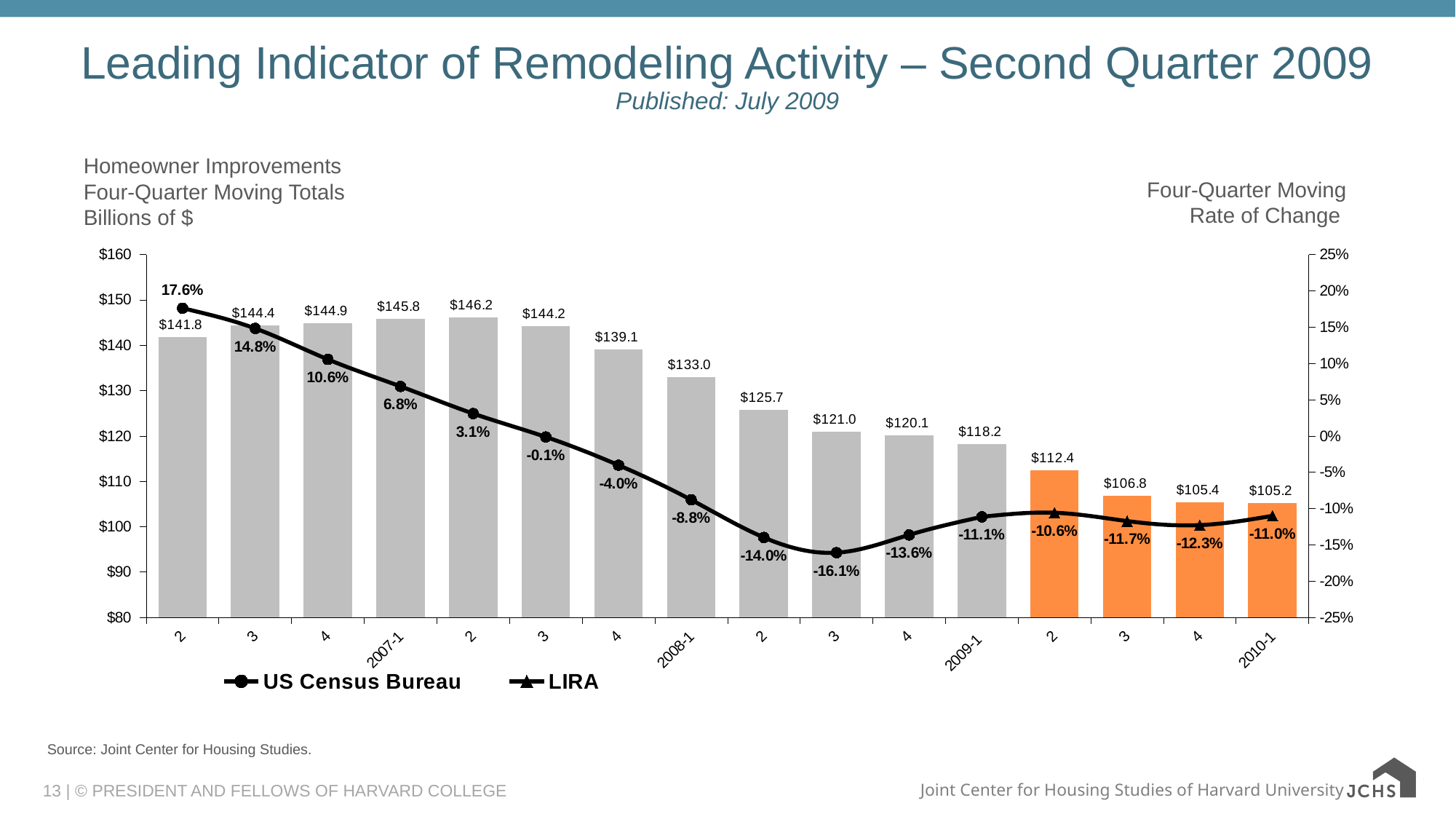
How many bars are plotted in the chart? 16 How many series does the legend list? 2 What is the four-quarter moving rate of change for 2008-1? -8.8% Do the four-quarter moving totals rise or fall from 2008-1 to 2010-1? fall What are the two series named in the legend? US Census Bureau and LIRA What is the four-quarter moving total for 2007-1? $145.8 What is the four-quarter moving rate of change for 2009-1? -11.1% What is the four-quarter moving total for 2010-1? $105.2 Which quarter has the lowest four-quarter moving rate of change? 2008 Q3 (-16.1%) Which quarter has the highest four-quarter moving total? 2007 Q2 ($146.2) What is the difference between the four-quarter moving totals for 2008-1 and 2009-1? $14.8 Which is larger, the four-quarter moving total for 2007-1 or for 2008-1? 2007-1